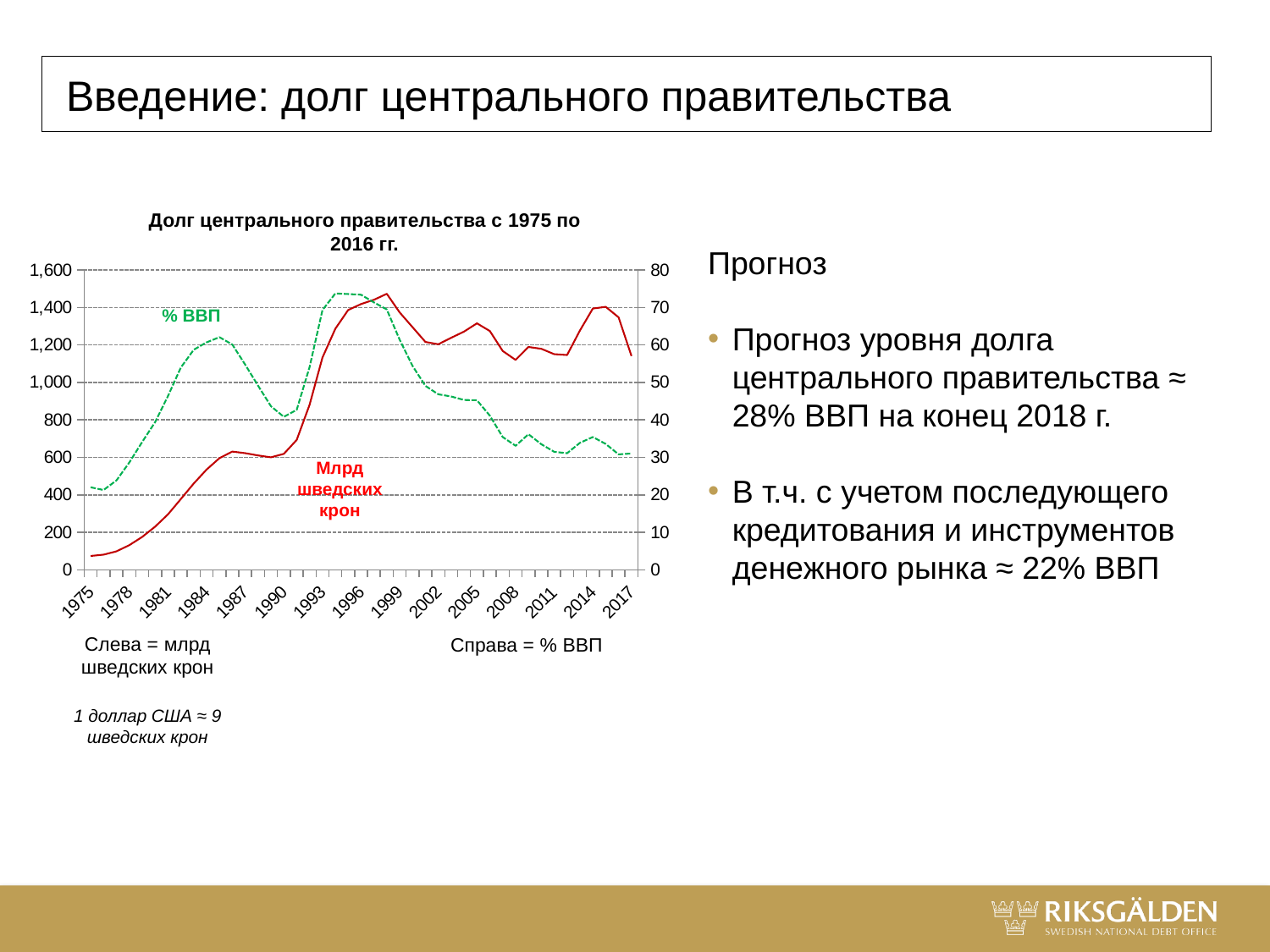
Is the peak value of the green dashed line (% ВВП) greater or less than 70? greater Is the value of the red line (Млрд шведских крон) in 2017 greater or less than 1,000? greater Is the value of the green dashed line (% ВВП) in 1987 greater or less than 50? greater What kind of chart is shown on the slide? Line chart Which series is plotted against the right-hand axis? % ВВП What is the title of the chart? Долг центрального правительства с 1975 по 2016 гг. How many year labels are shown on the x axis? 15 Does the red line (Млрд шведских крон) rise or fall between 1975 and 1996? Rise How many data series are plotted on the chart? 2